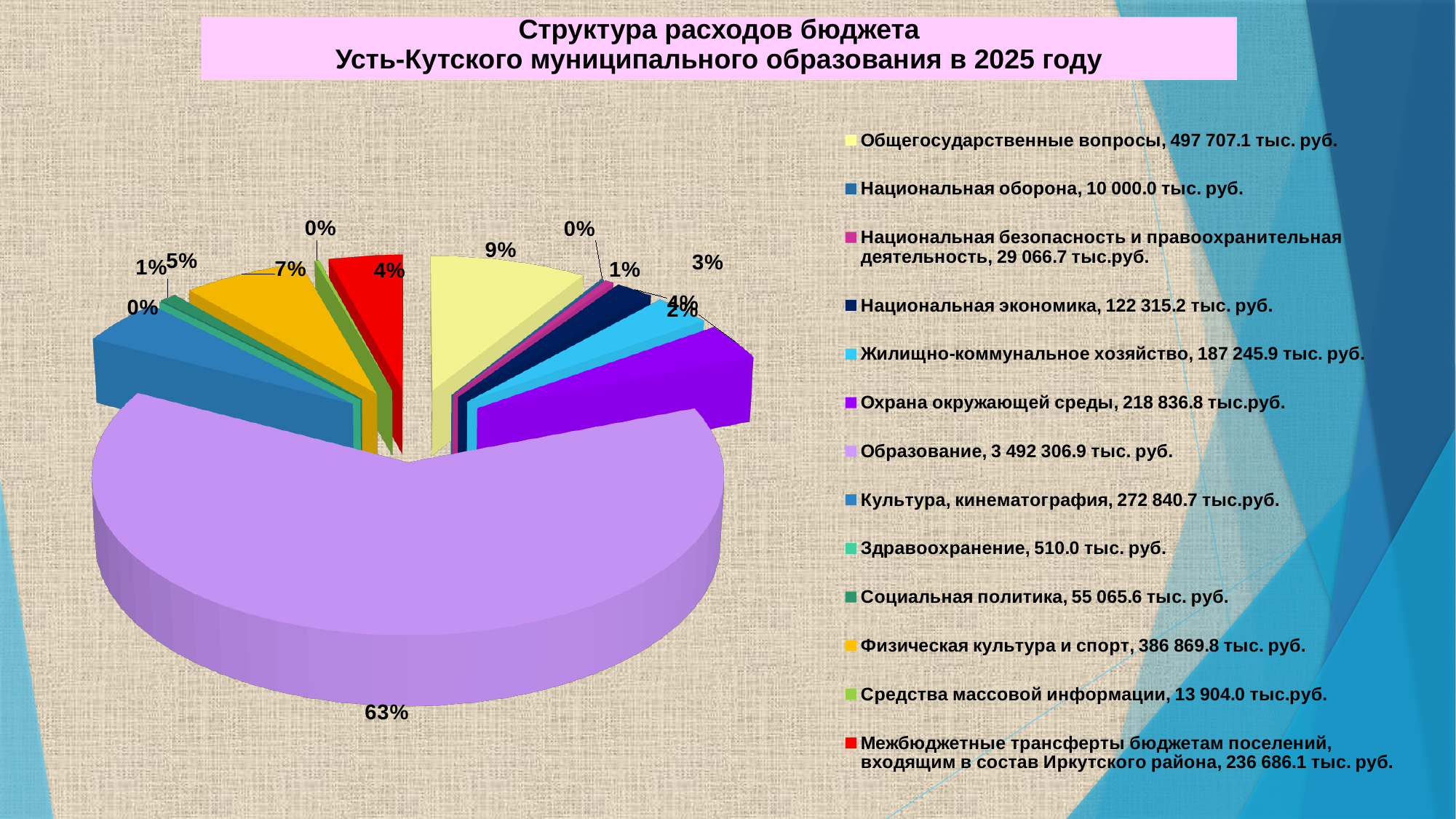
Which category has the largest share of the budget expenditures? Образование What share of the pie does Общегосударственные вопросы take? 9% What kind of chart is shown on the slide? pie chart What is the difference between Средства массовой информации and Национальная оборона? 3 904.0 тыс. руб. What amount is shown for Национальная оборона in the legend? 10 000.0 тыс. руб. What share of the pie does Образование take? 63% What amount is shown for Образование in the legend? 3 492 306.9 тыс. руб. What amount is shown for Физическая культура и спорт in the legend? 386 869.8 тыс. руб. Which is larger: Охрана окружающей среды or Жилищно-коммунальное хозяйство? Охрана окружающей среды Which category has the smallest amount in the legend? Здравоохранение How many categories does the legend of the pie chart list? 13 What year does the chart title refer to? 2025